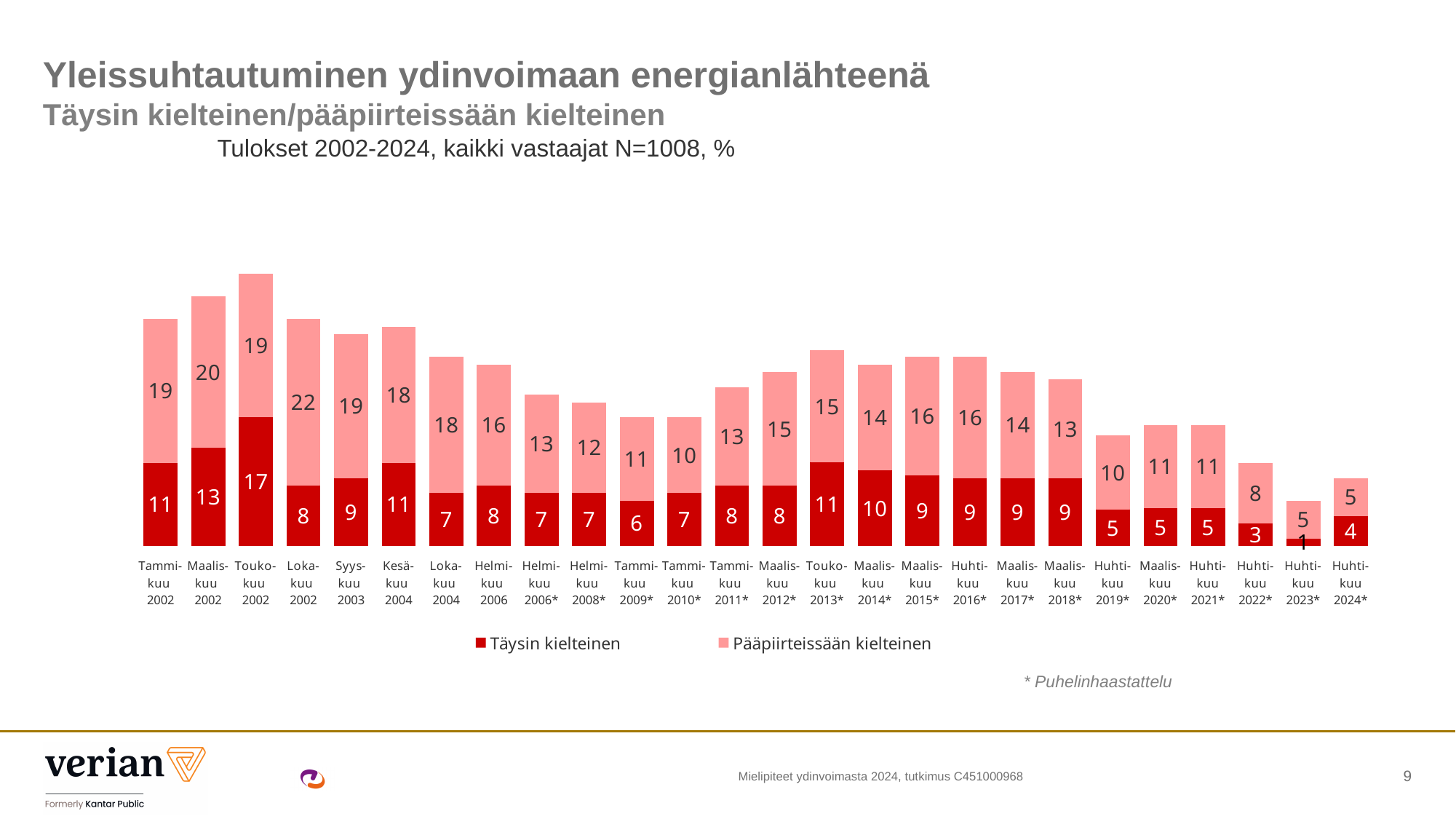
Which is larger: the Täysin kielteinen value for Toukokuu 2013* or for Maaliskuu 2018*? Toukokuu 2013* Which category has the highest Pääpiirteissään kielteinen value? Lokakuu 2002 What is the value of Täysin kielteinen for Toukokuu 2002? 17 Which category has the lowest Täysin kielteinen value? Huhtikuu 2023* What kind of chart is shown on the slide? Stacked bar chart Which category has the highest Täysin kielteinen value? Toukokuu 2002 What is the total of the stacked bar for Huhtikuu 2023*? 6 What is the total of the stacked bar for Toukokuu 2002? 36 What is the value of Pääpiirteissään kielteinen for Lokakuu 2002? 22 What is the value of Täysin kielteinen for Huhtikuu 2024*? 4 How many series does the legend list? 2 What is the difference between the Pääpiirteissään kielteinen values for Maaliskuu 2002 and Huhtikuu 2022*? 12